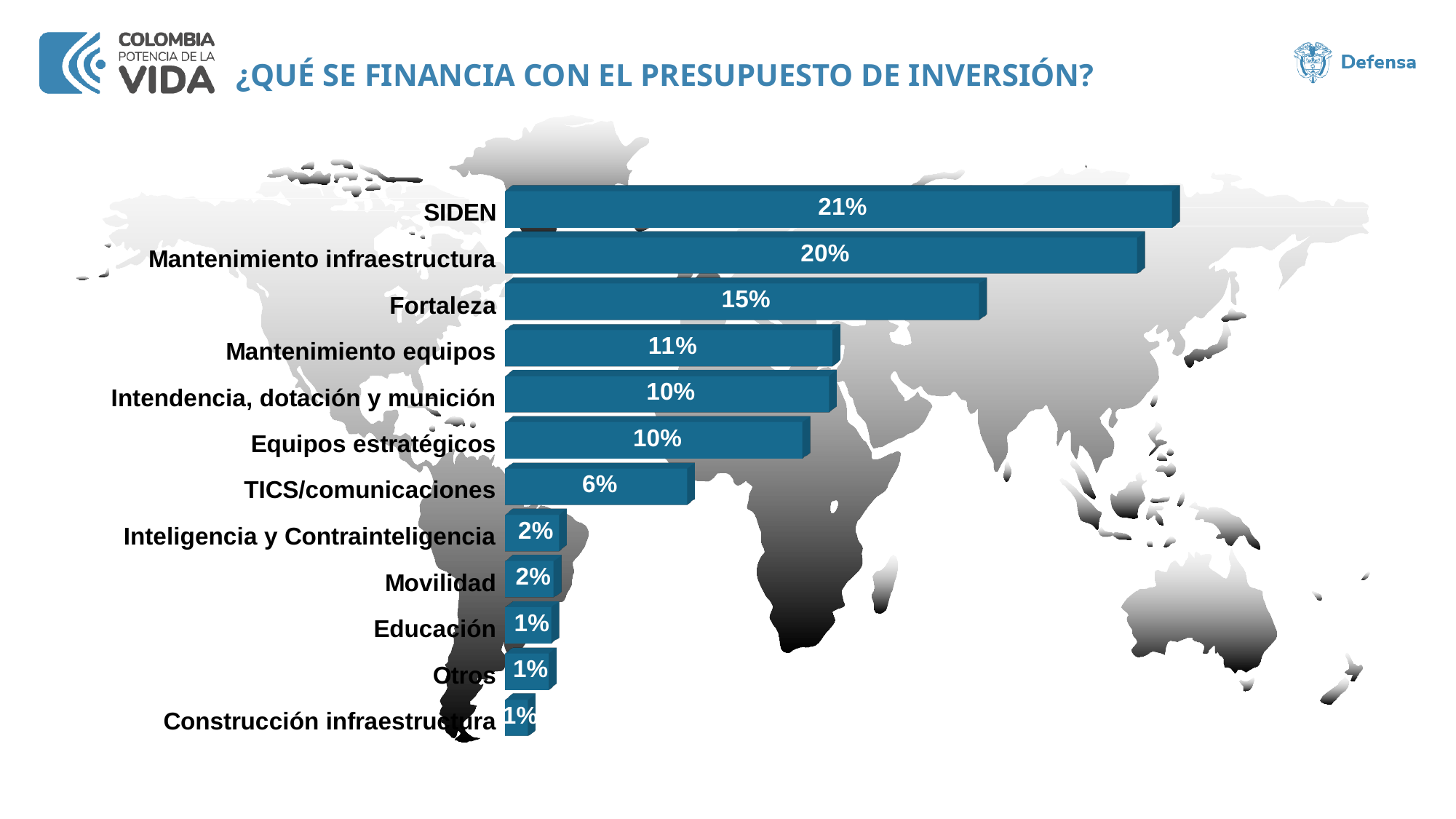
Which is larger, the value for Mantenimiento equipos or the value for TICS/comunicaciones? Mantenimiento equipos What is the value for Inteligencia y Contrainteligencia? 2% What is the difference between the values for SIDEN and Fortaleza? 6% What is the value for Mantenimiento infraestructura? 20% What is the value for TICS/comunicaciones? 6% How many categories are shown in the chart? 12 Which category has the highest value? SIDEN What is the value for Fortaleza? 15% What is the difference between the values for Mantenimiento infraestructura and Equipos estratégicos? 10% What is the value for SIDEN? 21% What kind of chart is shown on the slide? Bar chart What is the title of the slide containing the chart? ¿QUÉ SE FINANCIA CON EL PRESUPUESTO DE INVERSIÓN?